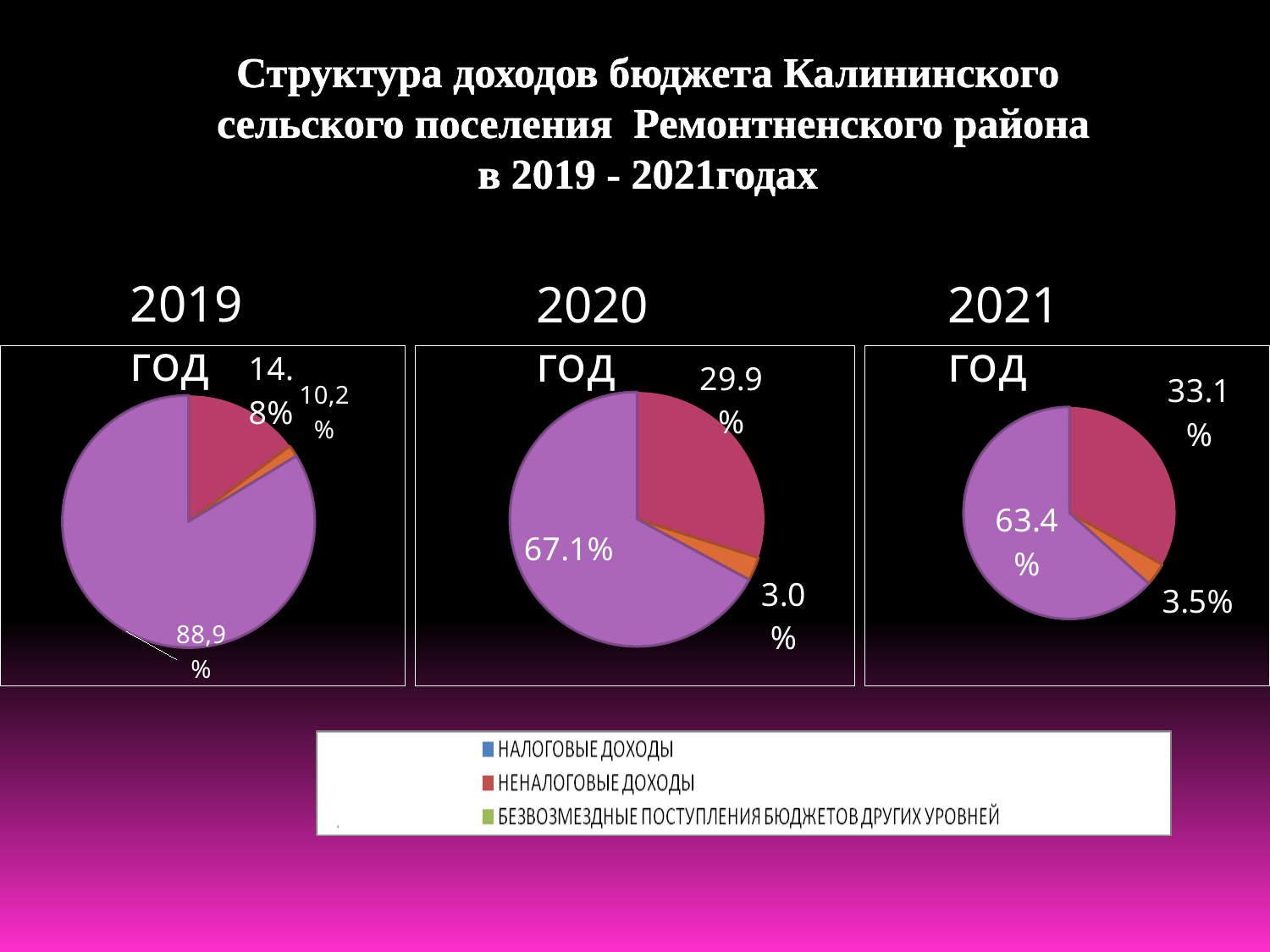
What kind of charts are shown on the slide? Pie charts In the 2020 год pie chart, what is the value of the red slice? 29.9% What is the difference between the red slice in the 2021 год chart (33.1%) and the red slice in the 2020 год chart (29.9%)? 3.2 percentage points In the 2021 год pie chart, what is the value of the red slice? 33.1% In the 2020 год pie chart, what is the value of the largest (purple) slice? 67.1% Which is larger: the orange slice in the 2020 год chart or the orange slice in the 2021 год chart? 2021 год In the 2021 год pie chart, what is the value of the smallest (orange) slice? 3.5% In the 2019 год pie chart, what is the value of the largest slice? 88,9% How many pie charts are on the slide? 3 How many entries does the legend list? 3 What is the difference between the purple slice in the 2020 год chart (67.1%) and the purple slice in the 2021 год chart (63.4%)? 3.7 percentage points What is the third entry listed in the legend? БЕЗВОЗМЕЗДНЫЕ ПОСТУПЛЕНИЯ БЮДЖЕТОВ ДРУГИХ УРОВНЕЙ